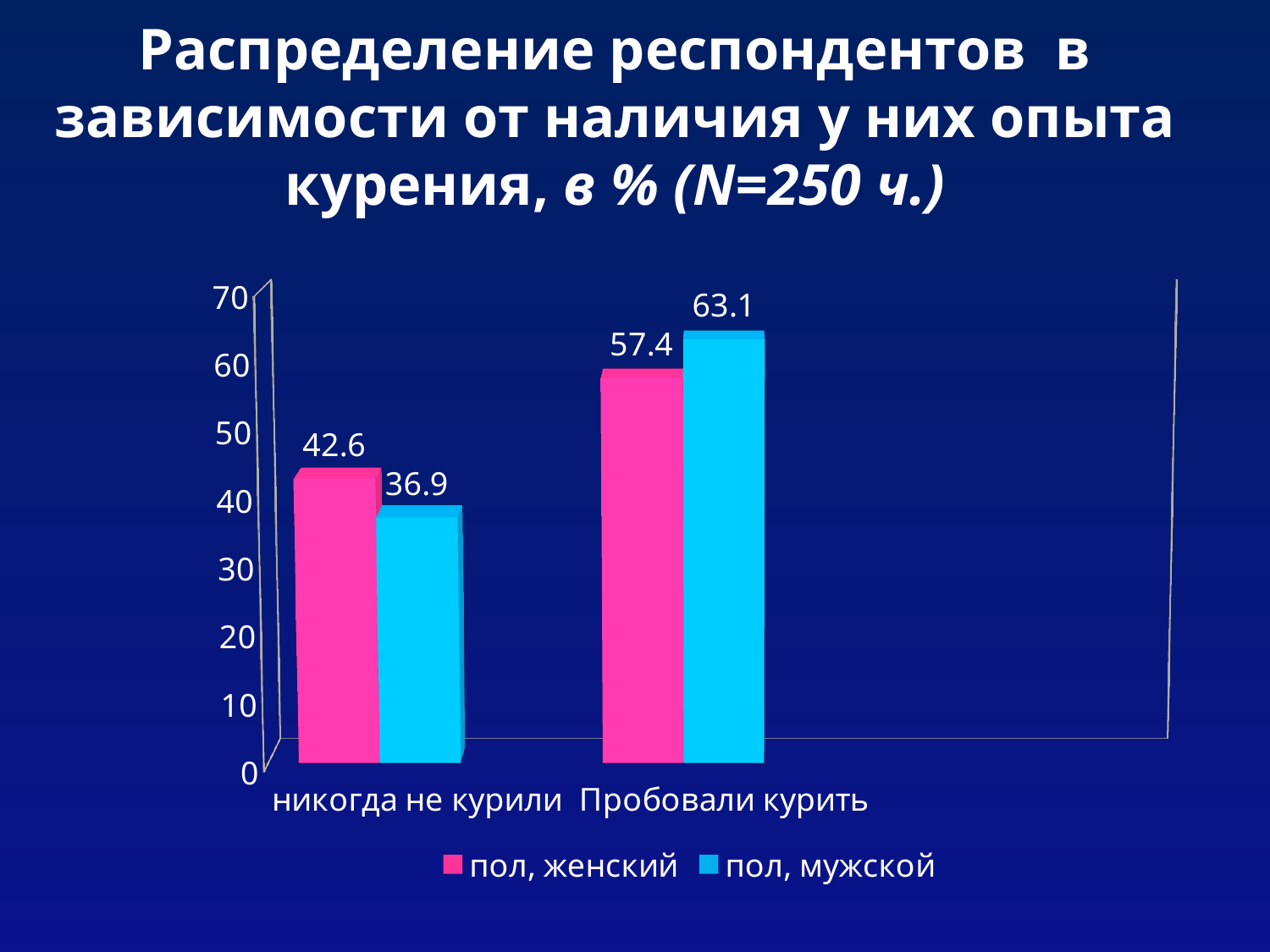
Which category has the highest value for 'пол, мужской'? Пробовали курить Which colour represents the 'пол, мужской' series? blue What is the value for 'пол, женский' in the 'никогда не курили' category? 42.6 Which category has the lowest value for 'пол, женский'? никогда не курили What is the value for 'пол, мужской' in the 'никогда не курили' category? 36.9 How many categories are shown on the x axis? 2 What is the value for 'пол, мужской' in the 'Пробовали курить' category? 63.1 What is the difference between the 'пол, мужской' and 'пол, женский' values in the 'Пробовали курить' category? 5.7 How many series does the legend list? 2 What is the value for 'пол, женский' in the 'Пробовали курить' category? 57.4 In the 'никогда не курили' category, which series has the larger value: 'пол, женский' or 'пол, мужской'? пол, женский What kind of chart is shown on the slide? bar chart